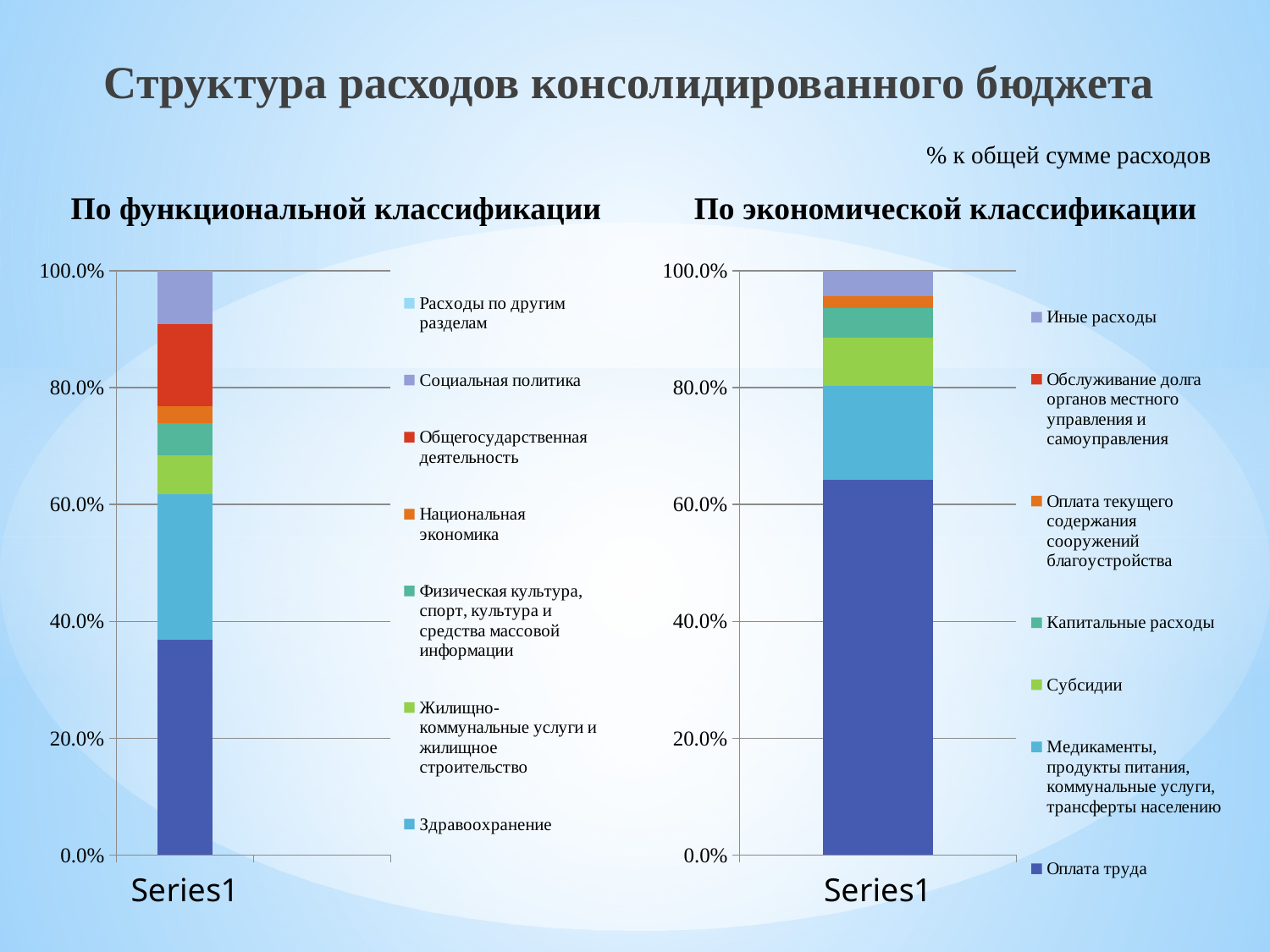
How many series does the legend of the 'По экономической классификации' chart list? 7 In the 'По функциональной классификации' chart, which is larger: the share for 'Здравоохранение' or for 'Общегосударственная деятельность'? Здравоохранение What is the title of the slide? Структура расходов консолидированного бюджета What unit note is shown above the charts on the slide? % к общей сумме расходов In the 'По экономической классификации' chart, which series takes the largest share of the bar? Оплата труда In the 'По экономической классификации' chart, which is larger: the share for 'Субсидии' or for 'Капитальные расходы'? Субсидии How many series does the legend of the 'По функциональной классификации' chart list? 7 In the 'По функциональной классификации' chart, is the share for 'Здравоохранение' greater or less than 20%? greater In the 'По экономической классификации' chart, is the share for 'Оплата труда' greater or less than 60%? greater What kind of chart is used on the slide for 'По функциональной классификации'? Stacked bar chart How many bars are plotted in the 'По экономической классификации' chart? 1